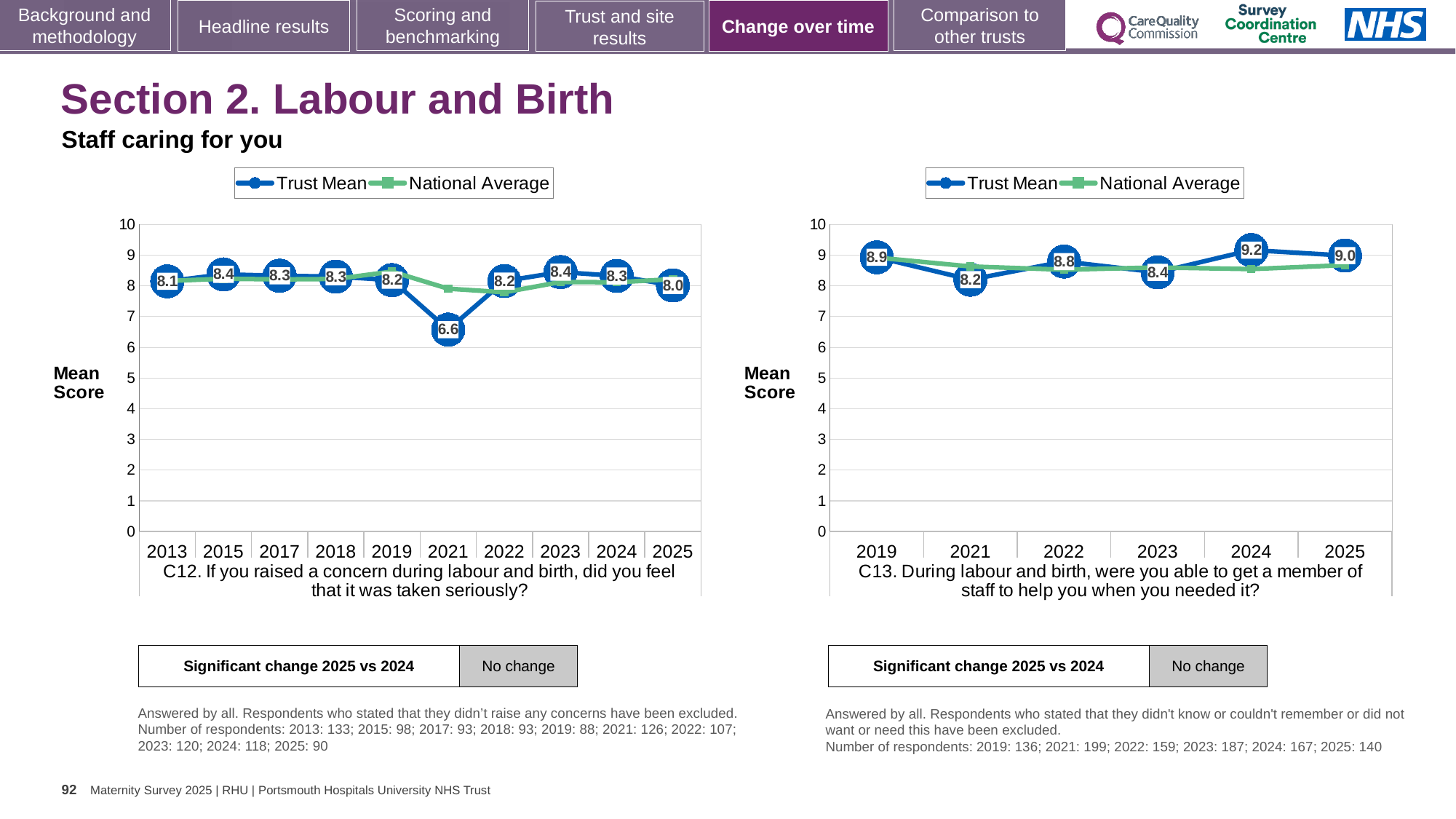
How many series does the legend of the right chart (C13) list? 2 What kind of chart is the left chart (C12)? Line chart In the right chart (C13), which year has the highest Trust Mean score? 2024 In the right chart (C13), what is the difference between the Trust Mean scores for 2024 and 2021? 1.0 In the right chart (C13), is the National Average value for 2021 greater or less than 8? greater In the left chart (C12), what is the difference between the Trust Mean scores for 2024 and 2021? 1.7 How many years are plotted on the x axis of the left chart (C12)? 10 In the right chart (C13), what is the Trust Mean score for 2024? 9.2 In the left chart (C12), what is the Trust Mean score for 2021? 6.6 In the right chart (C13), is the Trust Mean score larger in 2025 or in 2021? 2025 In the right chart (C13), which year has the lowest Trust Mean score? 2021 In the left chart (C12), which year has the lowest Trust Mean score? 2021